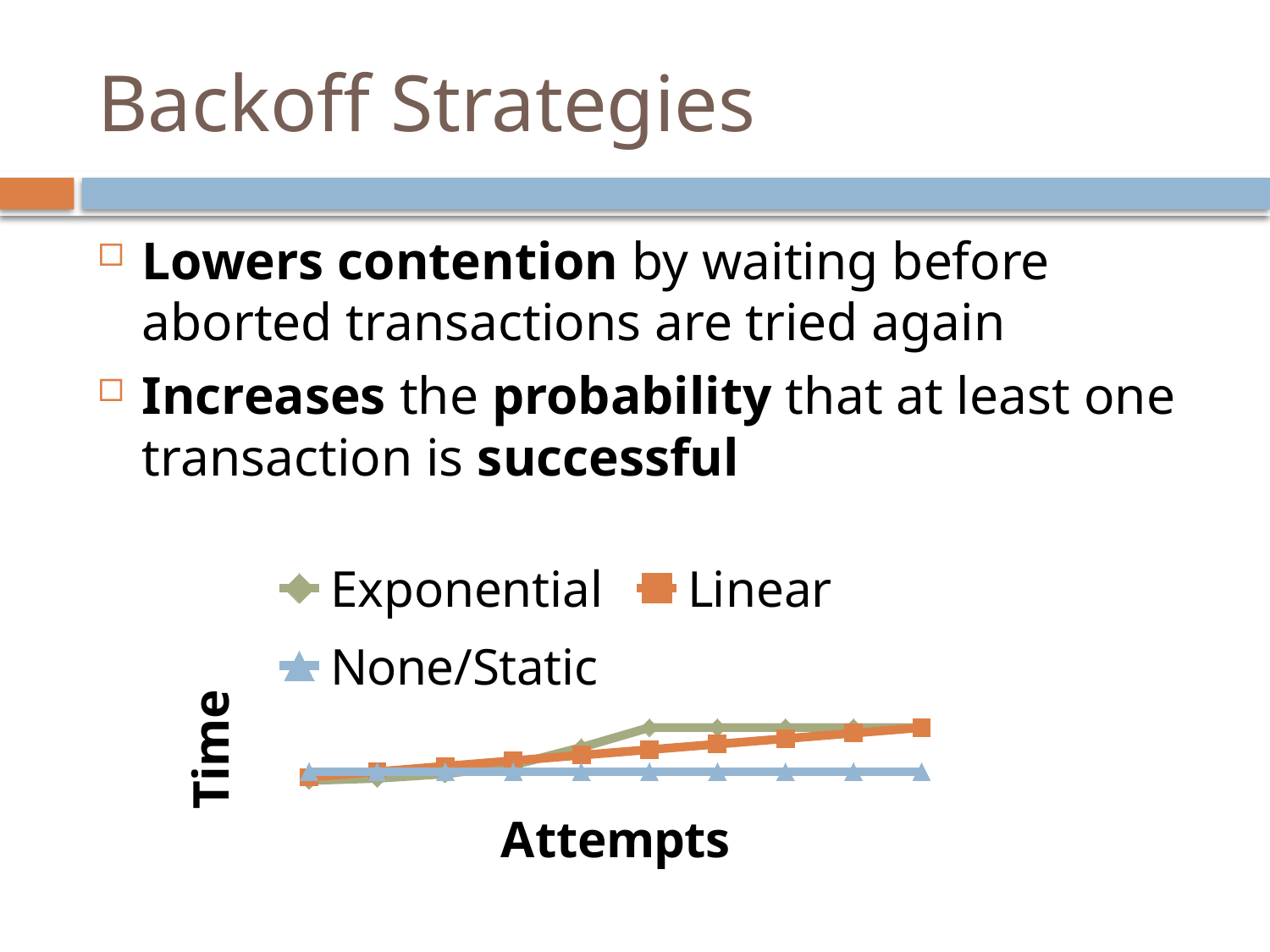
In the middle of the chart, which series has the higher Time, Exponential or Linear? Exponential Does the Time for the None/Static series rise, fall or stay flat as Attempts increase? stay flat How many series does the chart's legend list? 3 Does the Time for the Exponential series rise or fall as Attempts increase? rise What kind of chart is shown on the slide? line chart Which series has the lowest Time at the right end of the chart? None/Static What is the label of the chart's x axis? Attempts What are the three series named in the chart's legend? Exponential, Linear, None/Static Does the Time for the Linear series rise or fall as Attempts increase? rise How many data points are plotted for each series in the chart? 10 Which series stays below the other two across the later Attempts? None/Static